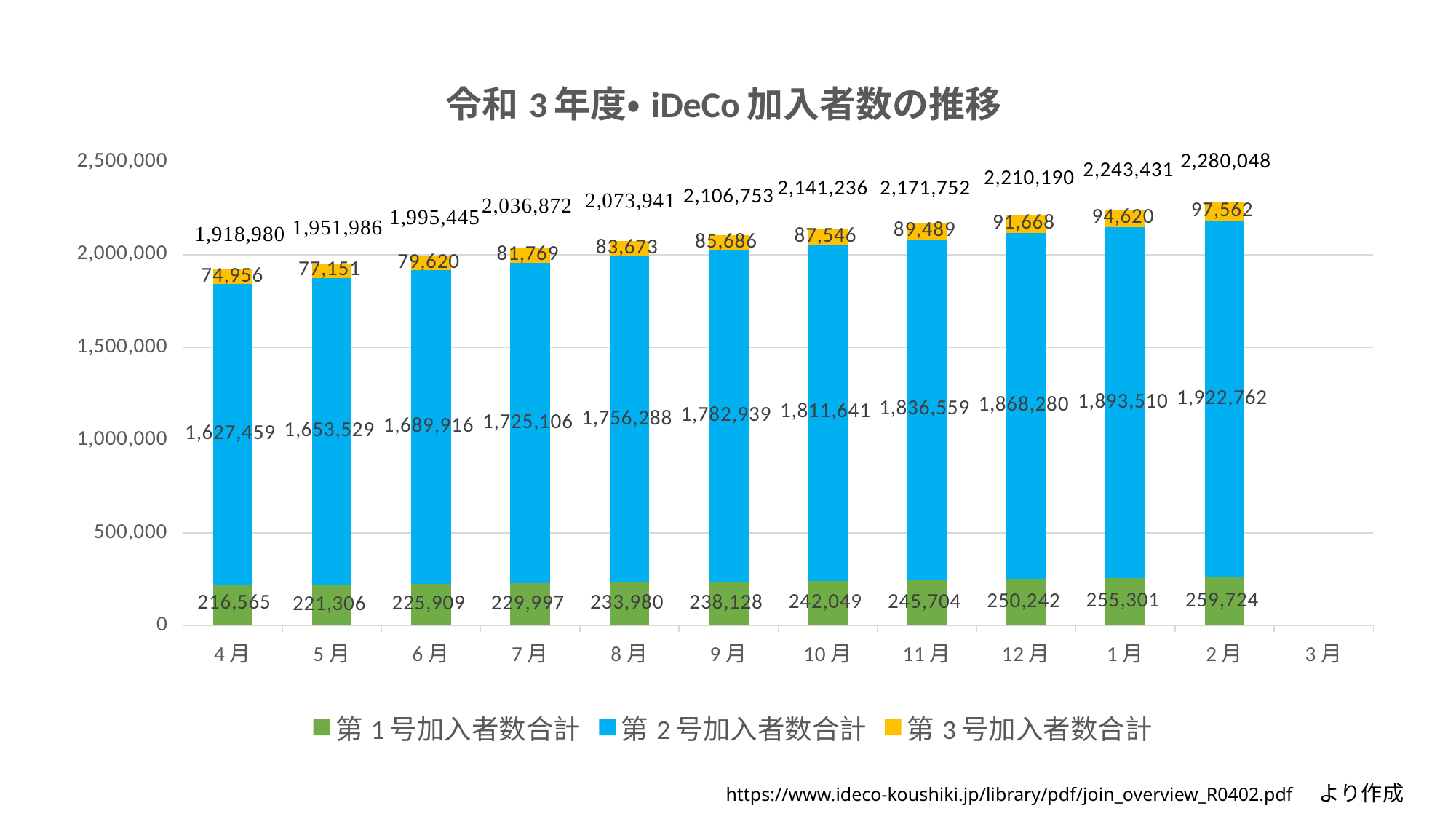
What kind of chart is shown on the slide? Stacked bar chart What is the difference between the 第１号加入者数合計 values for 2月 and 4月? 43,159 Do the total subscriber numbers rise or fall from 4月 to 2月? Rise What is the value of 第３号加入者数合計 for 10月? 87,546 Which is larger, the 第２号加入者数合計 value for 9月 or for 10月? 10月 Which month has the highest total number of subscribers? 2月 Which month has the lowest value for 第１号加入者数合計? 4月 What is the value of 第２号加入者数合計 for 2月? 1,922,762 What is the value of 第１号加入者数合計 for 4月? 216,565 What is the total shown above the bar for 12月? 2,210,190 How many series does the legend list? 3 By how much does the total for 2月 exceed the total for 1月? 36,617